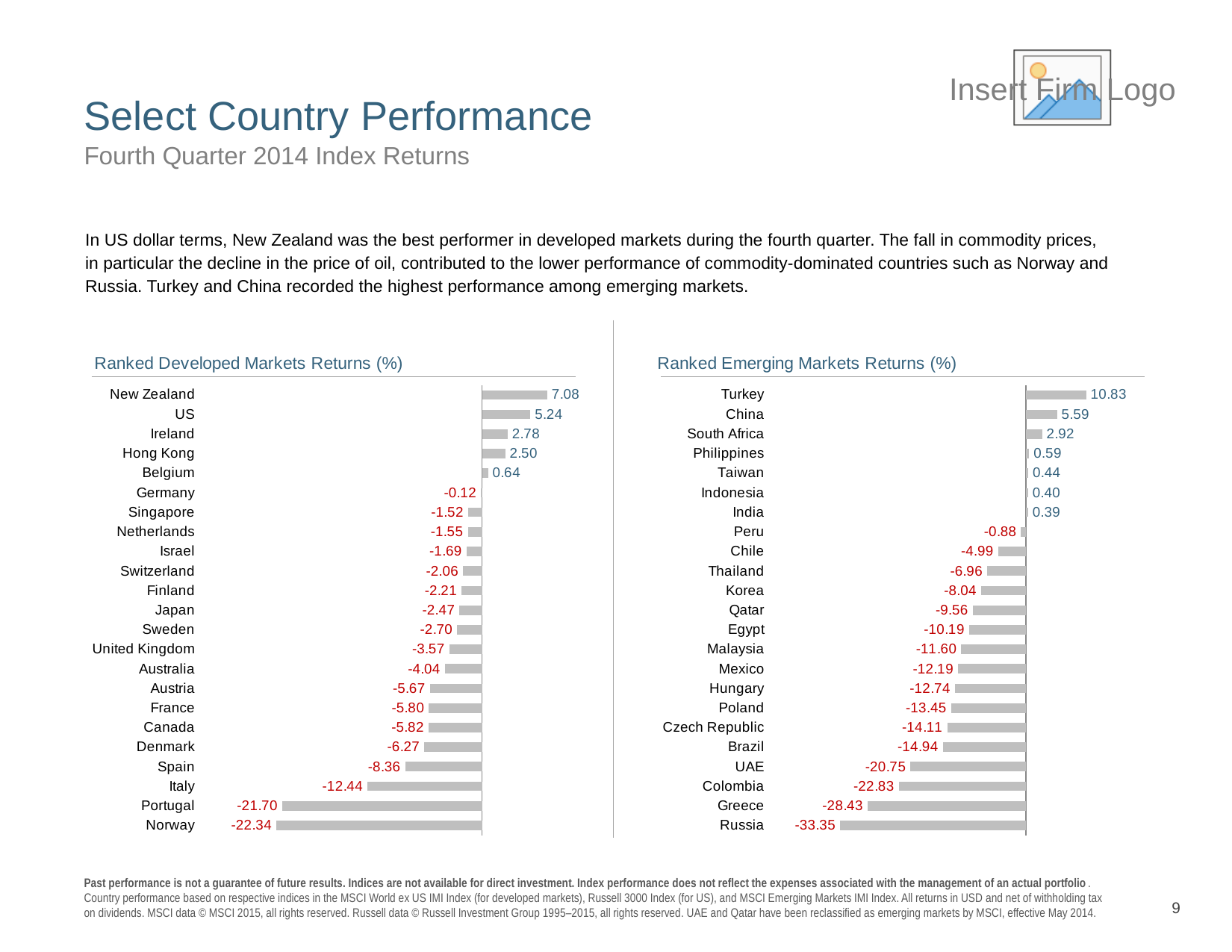
In the Ranked Developed Markets Returns (%) chart, what is the value for New Zealand? 7.08 In the Ranked Emerging Markets Returns (%) chart, which country has the highest return? Turkey In the Ranked Developed Markets Returns (%) chart, which country has the lowest return? Norway In the Ranked Emerging Markets Returns (%) chart, what is the value for Brazil? -14.94 What kind of chart is the Ranked Developed Markets Returns (%) chart? Bar chart In the Ranked Emerging Markets Returns (%) chart, what is the difference between the values for Turkey and China? 5.24 In the Ranked Developed Markets Returns (%) chart, what is the difference between the values for New Zealand and the US? 1.84 In the Ranked Emerging Markets Returns (%) chart, which country has the lowest return? Russia In the Ranked Developed Markets Returns (%) chart, what is the value for Canada? -5.82 What is the title of the chart on the right side of the slide? Ranked Emerging Markets Returns (%) How many countries are shown in the Ranked Emerging Markets Returns (%) chart? 23 In the Ranked Developed Markets Returns (%) chart, which is larger, the value for Ireland or the value for Hong Kong? Ireland